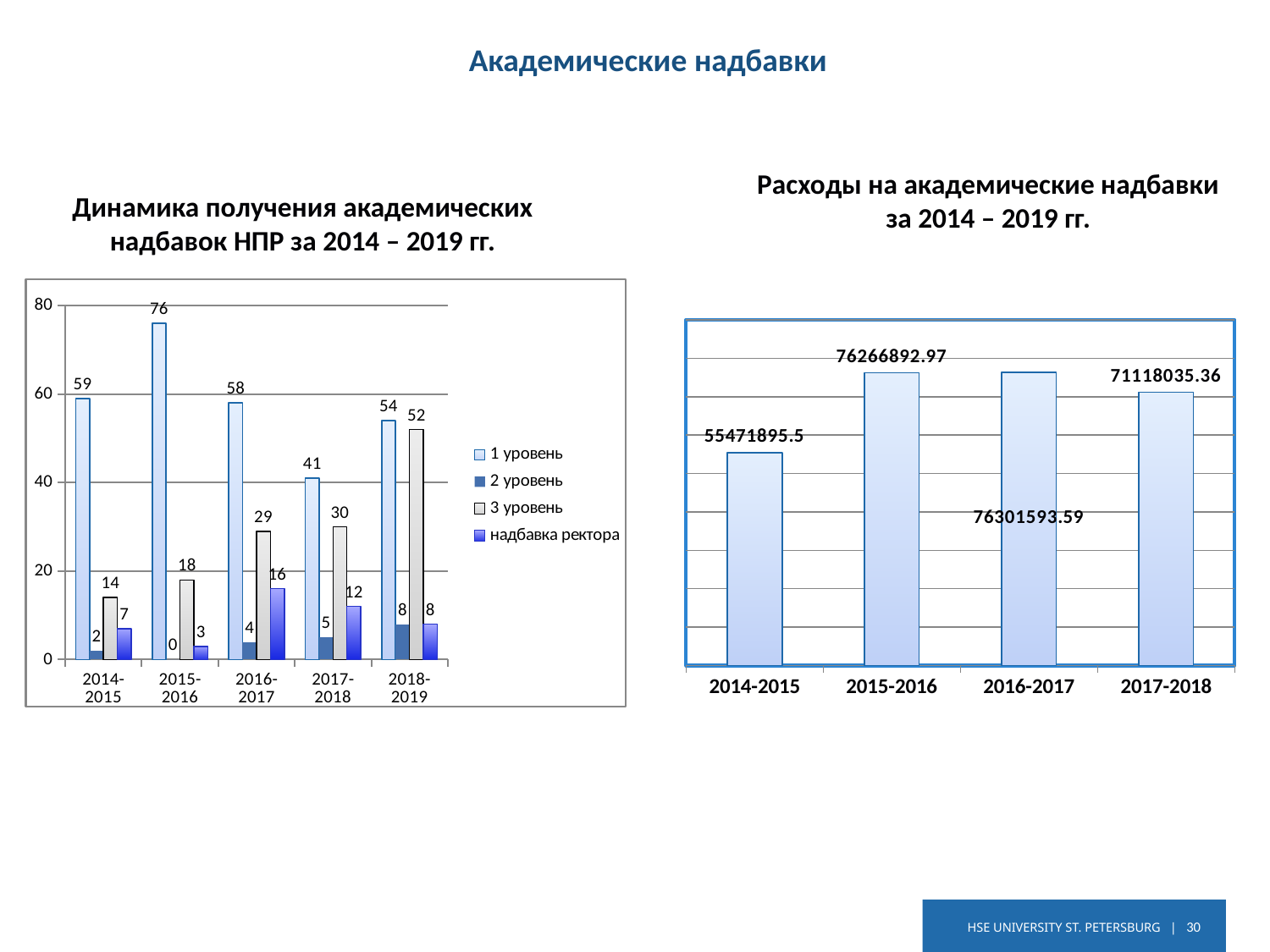
On the chart 'Динамика получения академических надбавок НПР за 2014 – 2019 гг.', in which year is the '1 уровень' value highest? 2015-2016 On the chart 'Динамика получения академических надбавок НПР за 2014 – 2019 гг.', which is larger in 2017-2018: '1 уровень' or '3 уровень'? 1 уровень On the chart 'Динамика получения академических надбавок НПР за 2014 – 2019 гг.', what is the value for '3 уровень' in 2018-2019? 52 What kind of chart is 'Расходы на академические надбавки за 2014 – 2019 гг.'? bar chart On the chart 'Динамика получения академических надбавок НПР за 2014 – 2019 гг.', what is the difference between the '1 уровень' values for 2015-2016 and 2014-2015? 17 On the chart 'Расходы на академические надбавки за 2014 – 2019 гг.', which year has the lowest value? 2014-2015 On the chart 'Динамика получения академических надбавок НПР за 2014 – 2019 гг.', how many series does the legend list? 4 On the chart 'Динамика получения академических надбавок НПР за 2014 – 2019 гг.', in which year is the '2 уровень' value lowest? 2015-2016 On the chart 'Расходы на академические надбавки за 2014 – 2019 гг.', what is the value for 2017-2018? 71118035.36 On the chart 'Динамика получения академических надбавок НПР за 2014 – 2019 гг.', what is the value for '1 уровень' in 2015-2016? 76 On the chart 'Динамика получения академических надбавок НПР за 2014 – 2019 гг.', what is the value for 'надбавка ректора' in 2016-2017? 16 On the chart 'Динамика получения академических надбавок НПР за 2014 – 2019 гг.', how many year categories are shown on the x axis? 5